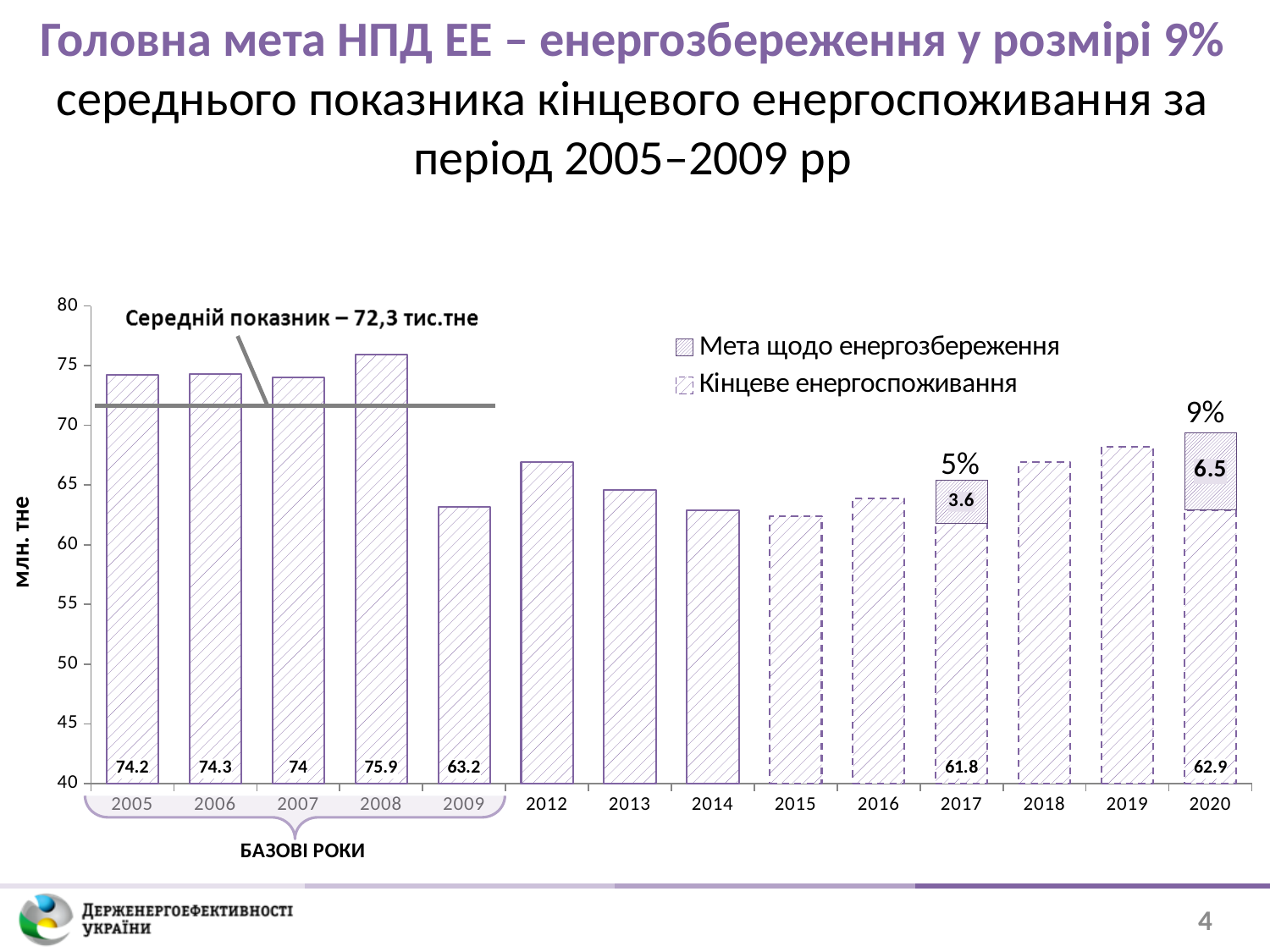
What is the energy saving target (Мета щодо енергозбереження) value for 2020? 6.5 Is the value for 2015 greater or less than 65? less What is the total of the stacked bar for 2020? 69.4 Is the value for 2012 greater or less than 65? greater Which is larger, the value for 2005 or the value for 2006? 2006 Which of the base years 2005–2009 has the highest value? 2008 How many years are shown on the x axis? 14 What is the value for 2009? 63.2 What is the final energy consumption (Кінцеве енергоспоживання) value for 2017? 61.8 What is the value for 2008? 75.9 What is the difference between the values for 2008 and 2009? 12.7 How many series does the legend list? 2